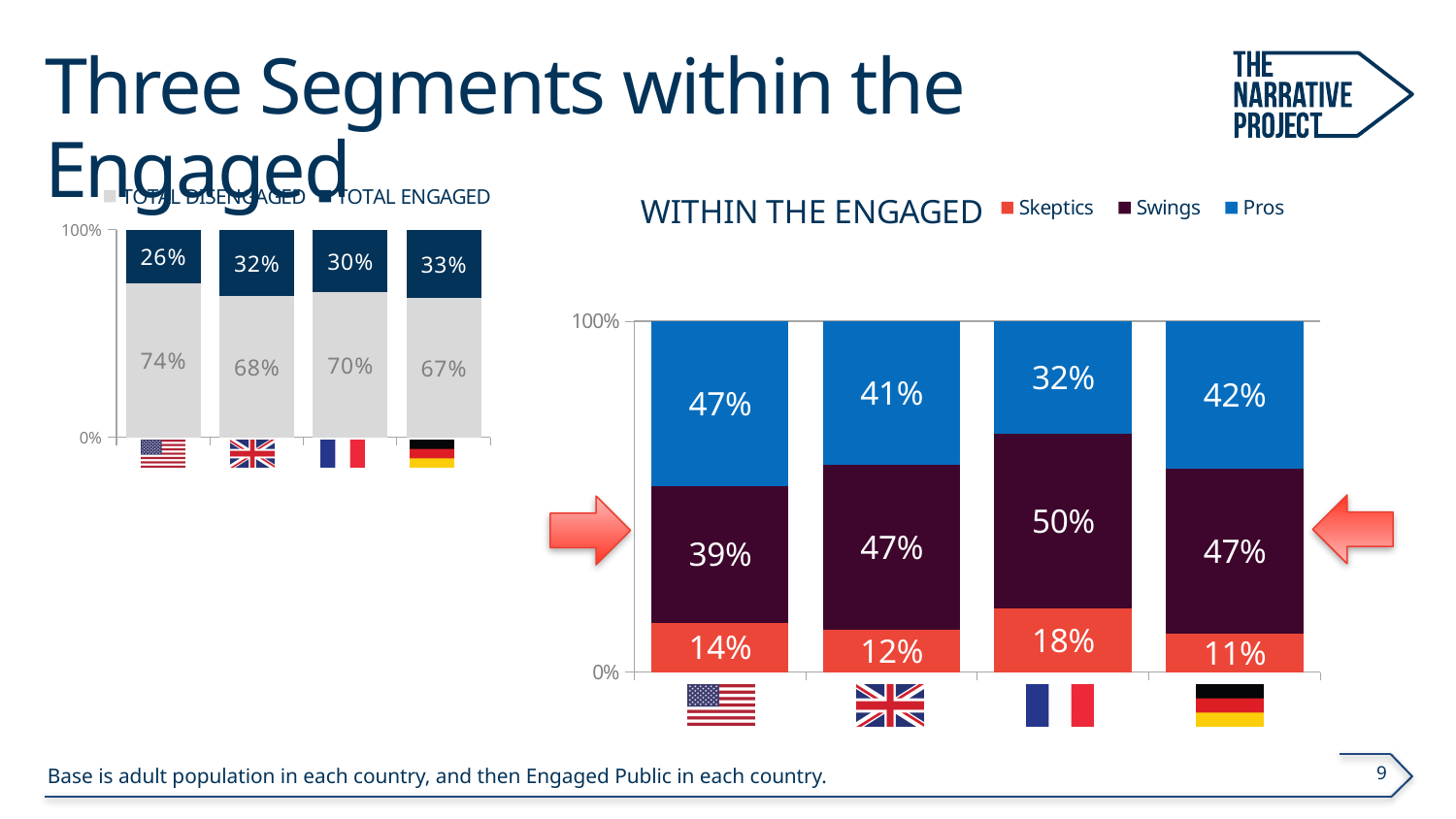
How many series does the legend of the 'WITHIN THE ENGAGED' chart list? 3 In the left chart (Total Disengaged / Total Engaged), what is the Total Engaged value for the bar with the German flag? 33% In the 'WITHIN THE ENGAGED' chart, is the Swings value or the Pros value larger for the bar with the UK flag? Swings (47% vs 41%) What kind of chart is the 'WITHIN THE ENGAGED' chart? Stacked bar chart In the 'WITHIN THE ENGAGED' chart, what is the difference between the Pros value for the US bar and the Pros value for the France bar? 15 percentage points In the left chart (Total Disengaged / Total Engaged), what is the Total Disengaged value for the bar with the US flag? 74% How many country bars are shown in the left chart (Total Disengaged / Total Engaged)? 4 In the 'WITHIN THE ENGAGED' chart, what is the Pros value for the bar with the French flag? 32% In the 'WITHIN THE ENGAGED' chart, which country's bar has the lowest Skeptics value? Germany (11%) In the 'WITHIN THE ENGAGED' chart, what is the Skeptics value for the bar with the German flag? 11% In the left chart (Total Disengaged / Total Engaged), which country's bar has the lowest Total Engaged value? United States (26%) In the 'WITHIN THE ENGAGED' chart, which country's bar has the highest Swings value? France (50%)